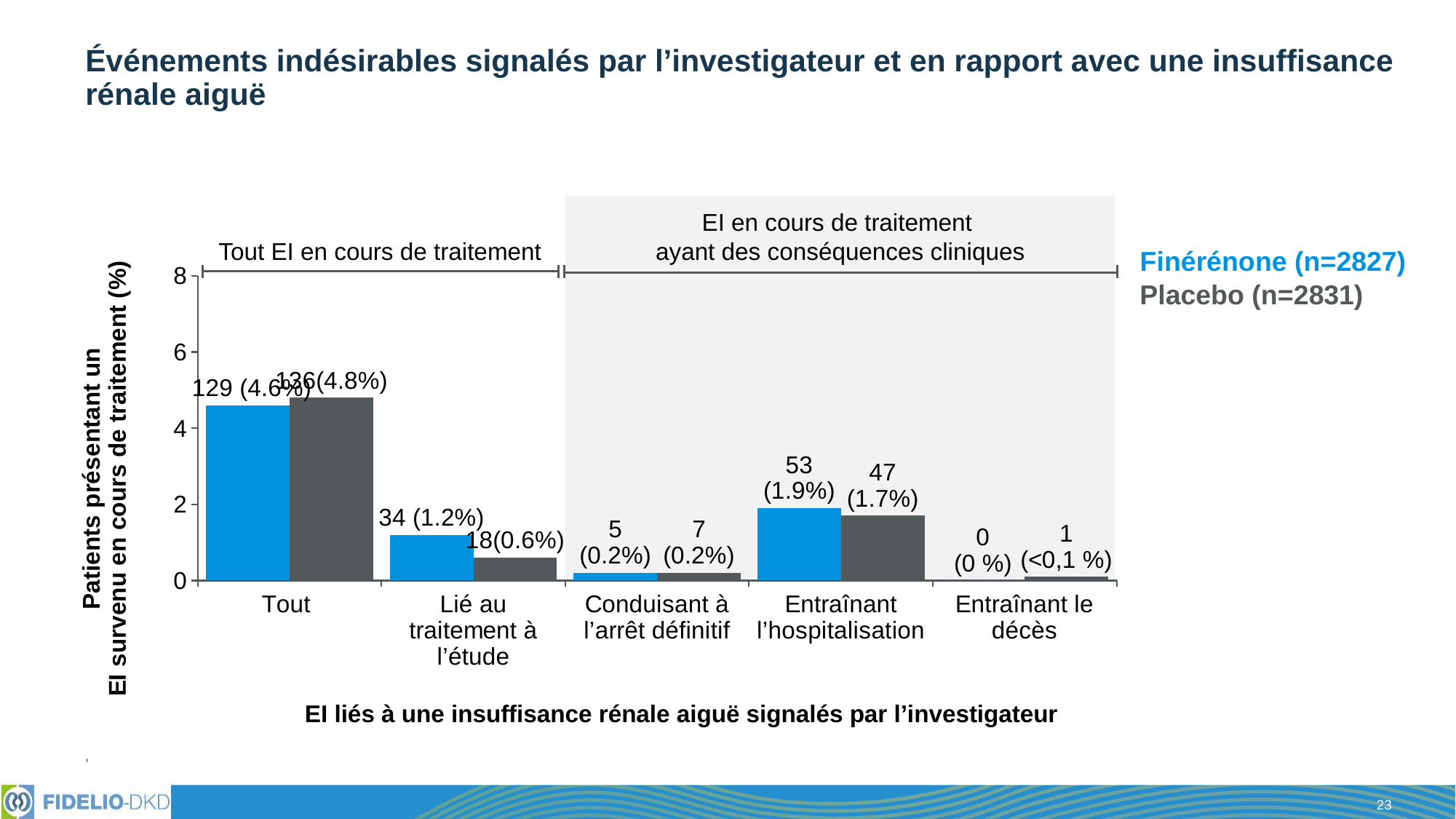
Is the value for Finérénone in the 'Tout' category greater or less than 4? greater What is the difference in patient counts between Finérénone and Placebo for 'Entraînant l'hospitalisation'? 6 What is the sample size (n) given for the Placebo group in the legend? n=2831 Which category has the highest value for Placebo? Tout What kind of chart is shown on the slide? bar chart What is the value for Placebo in the 'Tout' category? 136 (4.8%) How many categories are shown along the x axis? 5 What is the value for Finérénone in the 'Entraînant le décès' category? 0 (0 %) What is the value for Placebo in the 'Entraînant l'hospitalisation' category? 47 (1.7%) How many series does the legend list? 2 What is the value for Finérénone in the 'Lié au traitement à l'étude' category? 34 (1.2%) In the 'Lié au traitement à l'étude' category, which series has the larger value, Finérénone or Placebo? Finérénone